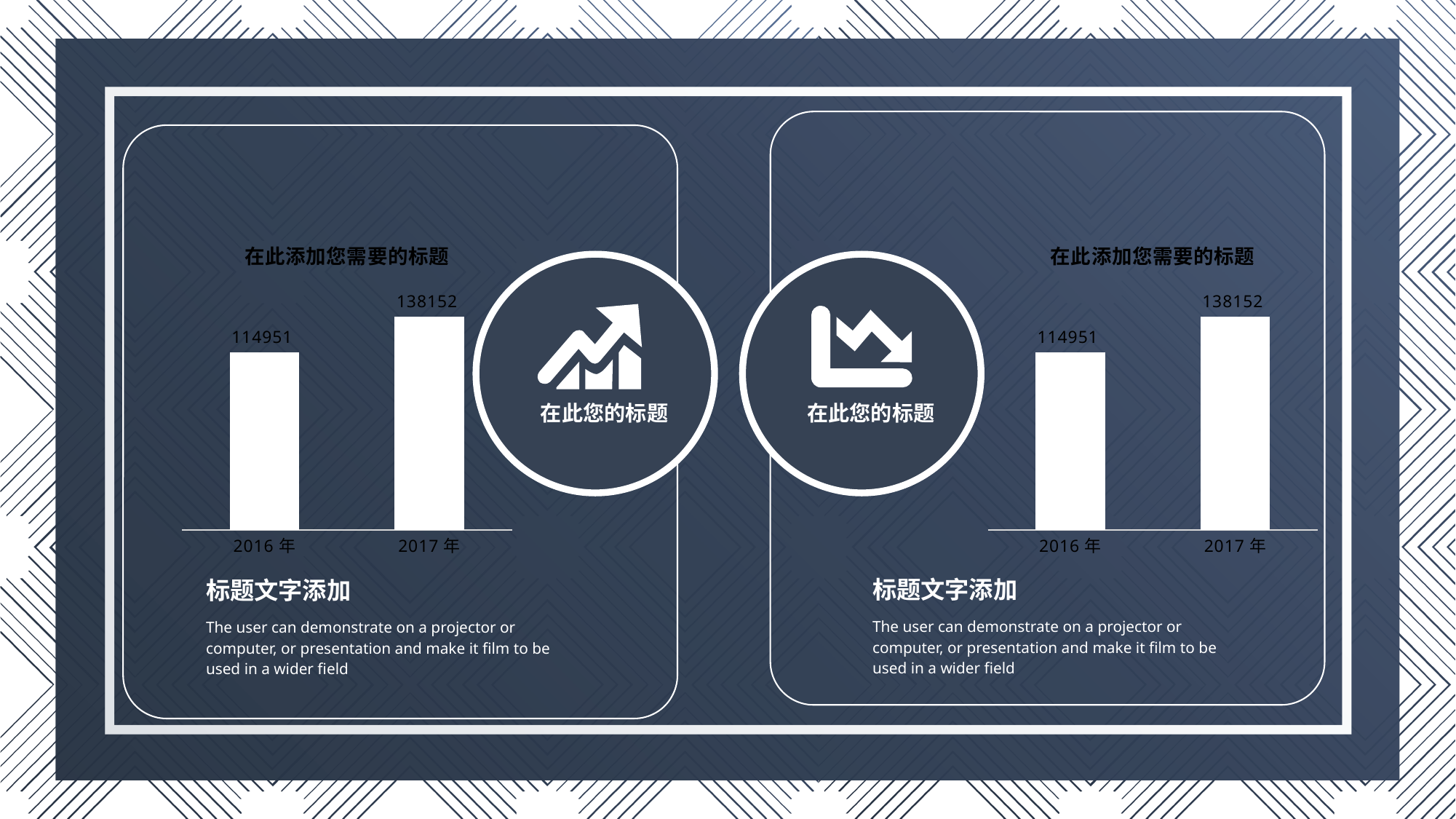
In the left chart, do the values rise or fall from 2016 年 to 2017 年? rise In the right chart, what is the value for 2016 年? 114951 How many categories are shown in the left chart? 2 In the left chart, what is the value for 2017 年? 138152 What kind of chart is the right chart? bar chart How many charts are on the slide? 2 In the left chart, what is the value for 2016 年? 114951 In the left chart, what is the difference between the 2017 年 and 2016 年 values? 23201 In the right chart, which is larger, the value for 2016 年 or 2017 年? 2017 年 In the right chart, what is the value for 2017 年? 138152 In the right chart, which category has the lowest value? 2016 年 In the left chart, which category has the highest value? 2017 年